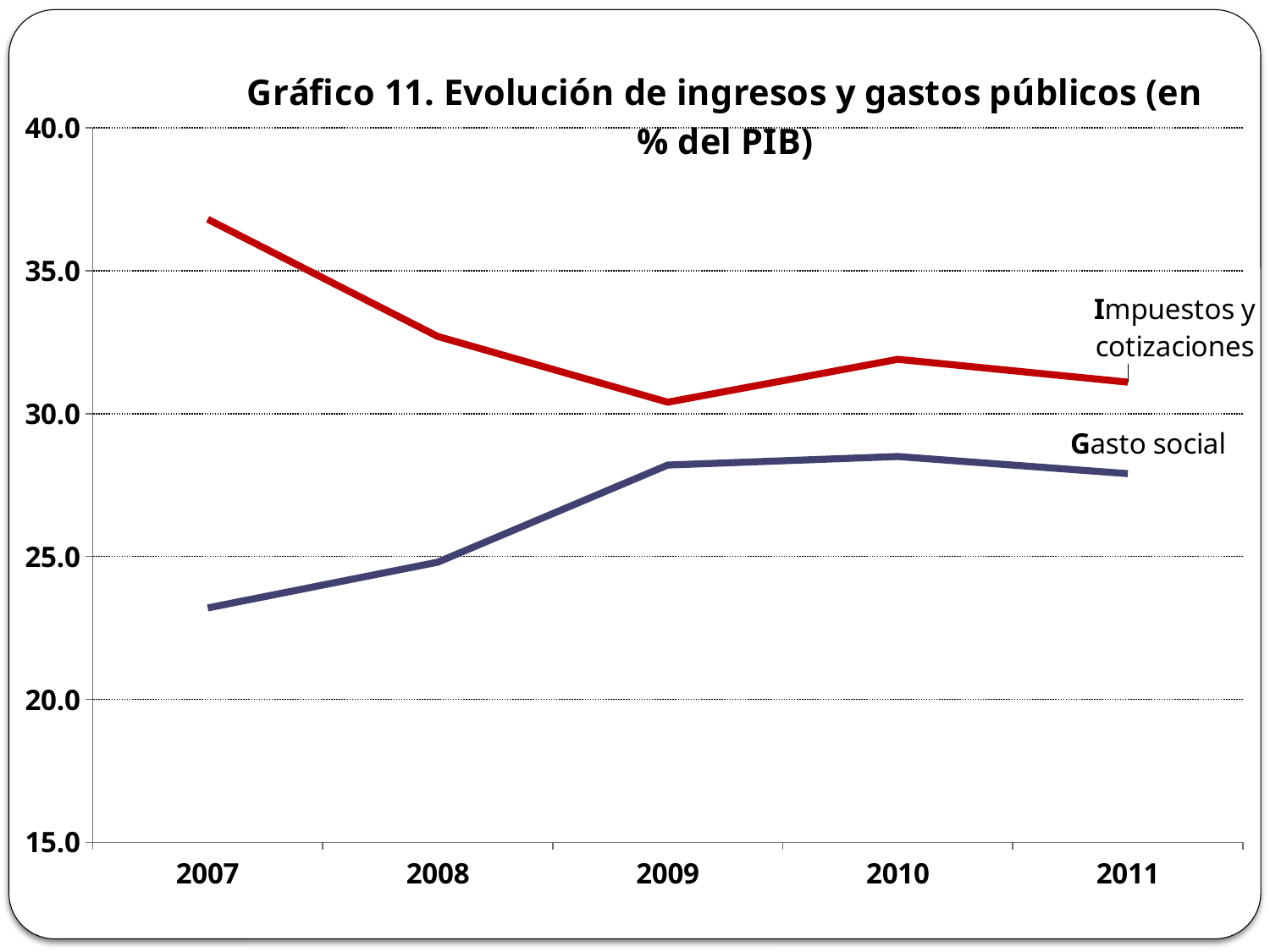
Is the value for Gasto social in 2010 greater or less than 30.0? less Is the value for Impuestos y cotizaciones in 2007 greater or less than 35.0? greater In which year is the value for Impuestos y cotizaciones highest? 2007 What kind of chart is shown on the slide? line chart Which series has the larger value in 2011, Impuestos y cotizaciones or Gasto social? Impuestos y cotizaciones Does the Impuestos y cotizaciones line rise or fall from 2007 to 2009? fall In which year is the value for Impuestos y cotizaciones lowest? 2009 Is the value for Gasto social in 2008 greater or less than 25.0? less How many series are plotted in the chart? 2 What is the title of the chart? Gráfico 11. Evolución de ingresos y gastos públicos (en % del PIB) In which year is the value for Gasto social lowest? 2007 How many years are shown on the x axis of the chart? 5